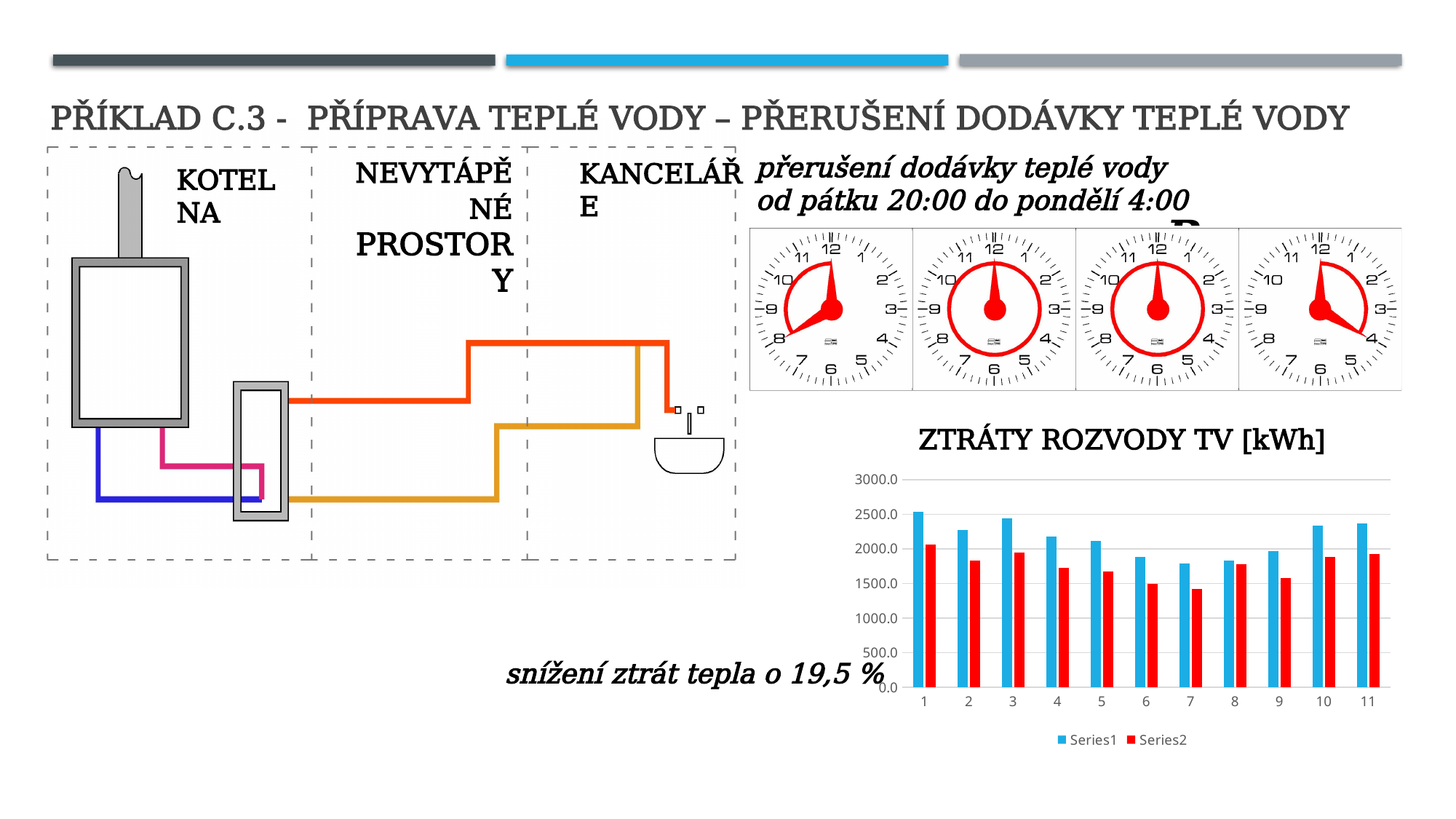
For category 4, which is larger, Series1 or Series2? Series1 Is the Series2 value for category 7 greater or less than 1500.0? less Do the Series1 values rise or fall from category 7 to category 11? rise Which category has the highest Series1 value? 1 Is the Series1 value for category 1 greater or less than 2000.0? greater What type of chart is shown on the slide? bar chart What is the title of the chart? ZTRÁTY ROZVODY TV [kWh] Which category has the lowest Series2 value? 7 Which colour represents Series2 in the chart? red How many series does the chart legend list? 2 How many categories are shown on the x axis of the chart? 11 Is the Series1 value for category 7 greater or less than 2000.0? less